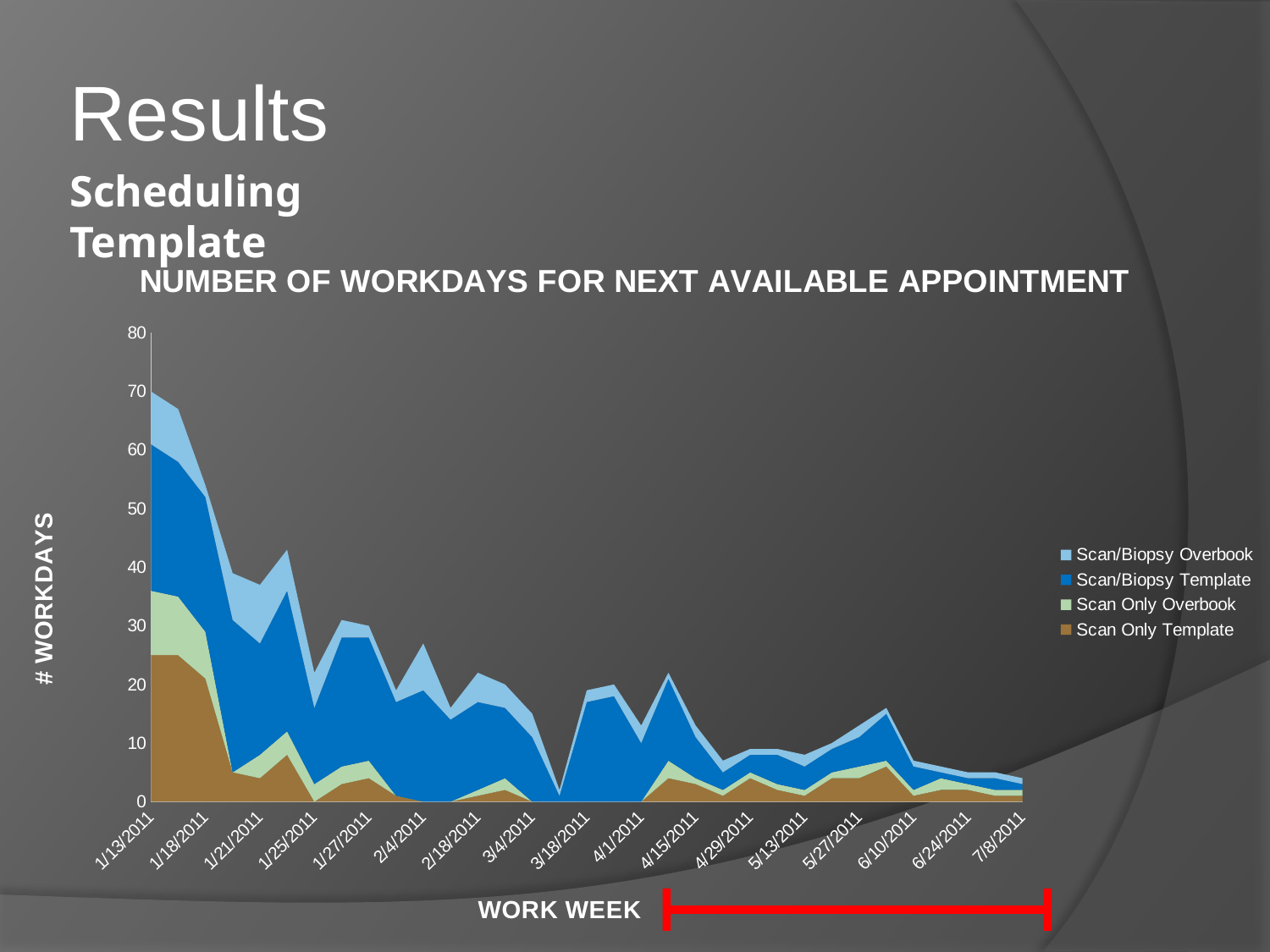
Which has a larger total number of workdays, 1/13/2011 or 7/8/2011? 1/13/2011 What is the title of the chart? NUMBER OF WORKDAYS FOR NEXT AVAILABLE APPOINTMENT Is the total number of workdays at 3/18/2011 greater or less than 10? greater How many series does the legend list? 4 Do the total number of workdays generally rise or fall along the x axis from 1/13/2011 to 7/8/2011? Fall Is the total number of workdays at 1/13/2011 greater or less than 60? greater Which has a larger total number of workdays, 1/25/2011 or 4/29/2011? 1/25/2011 Is the total number of workdays at 7/8/2011 greater or less than 10? less At which work week is the total number of workdays highest? 1/13/2011 What is the label on the vertical axis? # WORKDAYS What kind of chart is shown on the slide? Stacked area chart